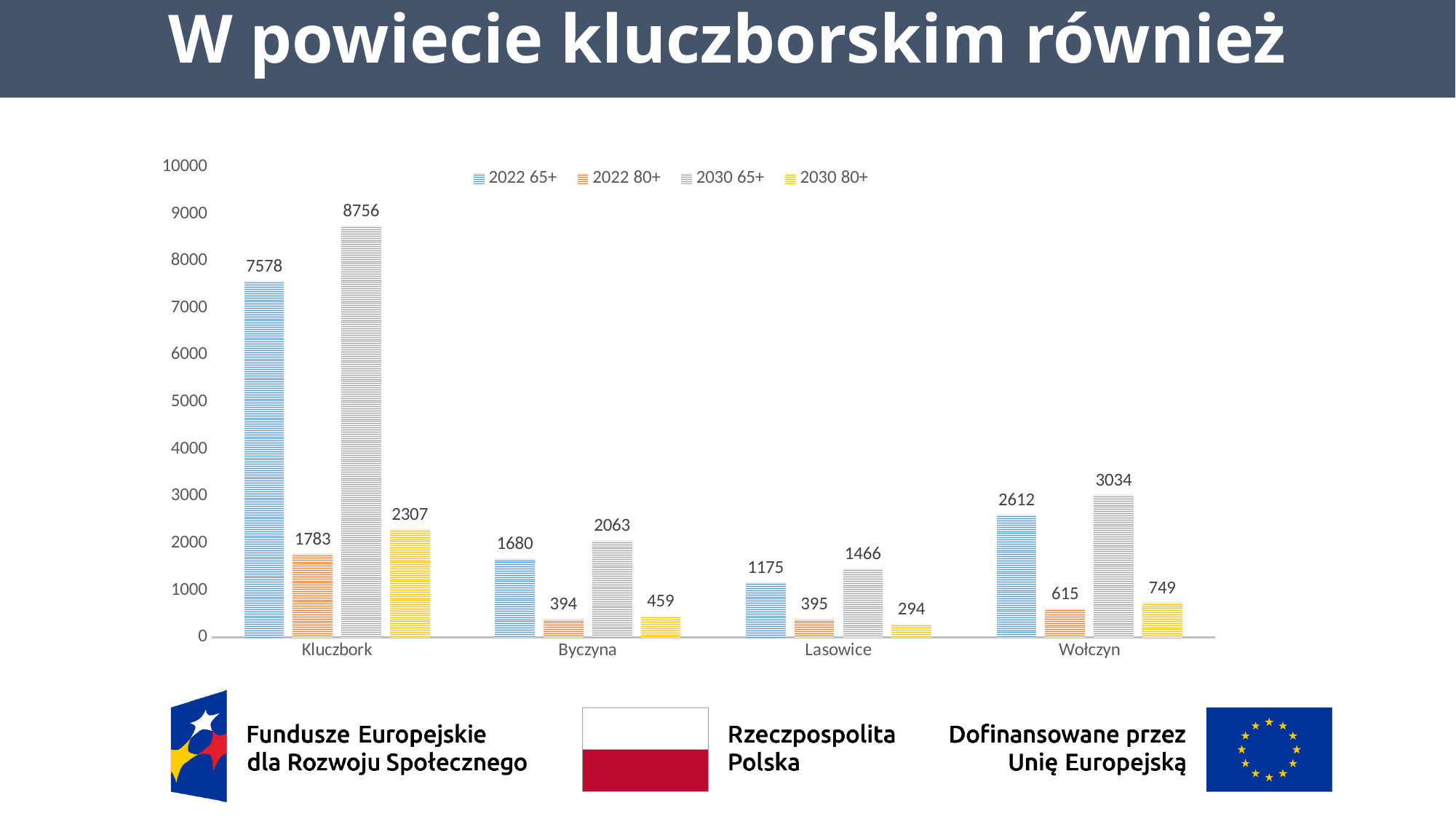
What is the difference between the 2030 65+ and 2022 65+ values for Kluczbork? 1178 How many categories are shown on the x axis? 4 Which category has the lowest value for 2030 80+? Lasowice What is the value for 2022 80+ in Byczyna? 394 What is the value for 2030 80+ in Wołczyn? 749 What is the title of the slide? W powiecie kluczborskim również What is the value for 2022 65+ in Kluczbork? 7578 Which is larger in Lasowice: the 2022 80+ value or the 2030 80+ value? 2022 80+ Is the value for 2022 65+ in Wołczyn greater or less than 2000? greater How many series does the legend list? 4 Which category has the highest value for 2030 65+? Kluczbork What kind of chart is shown on the slide? bar chart